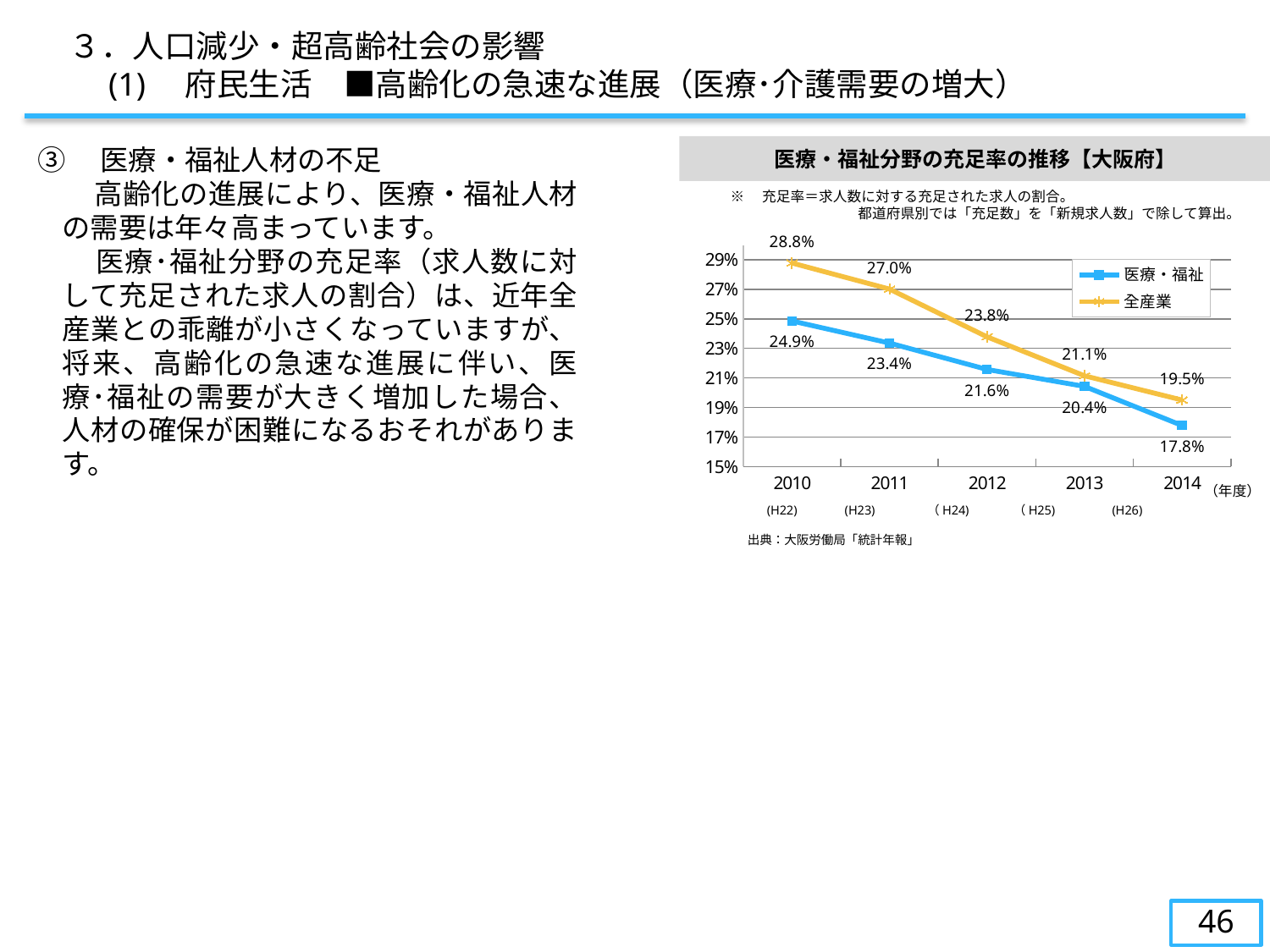
What is the difference between 全産業 and 医療・福祉 in 2014? 1.7% What is the value for 医療・福祉 in 2010? 24.9% What is the value for 全産業 in 2011? 27.0% What is the value for 全産業 in 2014? 19.5% In which year is the 全産業 series highest? 2010 Which is larger in 2013, 全産業 or 医療・福祉? 全産業 In which year is the 医療・福祉 series lowest? 2014 Do the values for 医療・福祉 rise or fall from 2010 to 2014? fall What type of chart is shown on the slide? line chart What is the difference between 全産業 and 医療・福祉 in 2010? 3.9% How many series does the legend list? 2 What is the value for 医療・福祉 in 2012? 21.6%